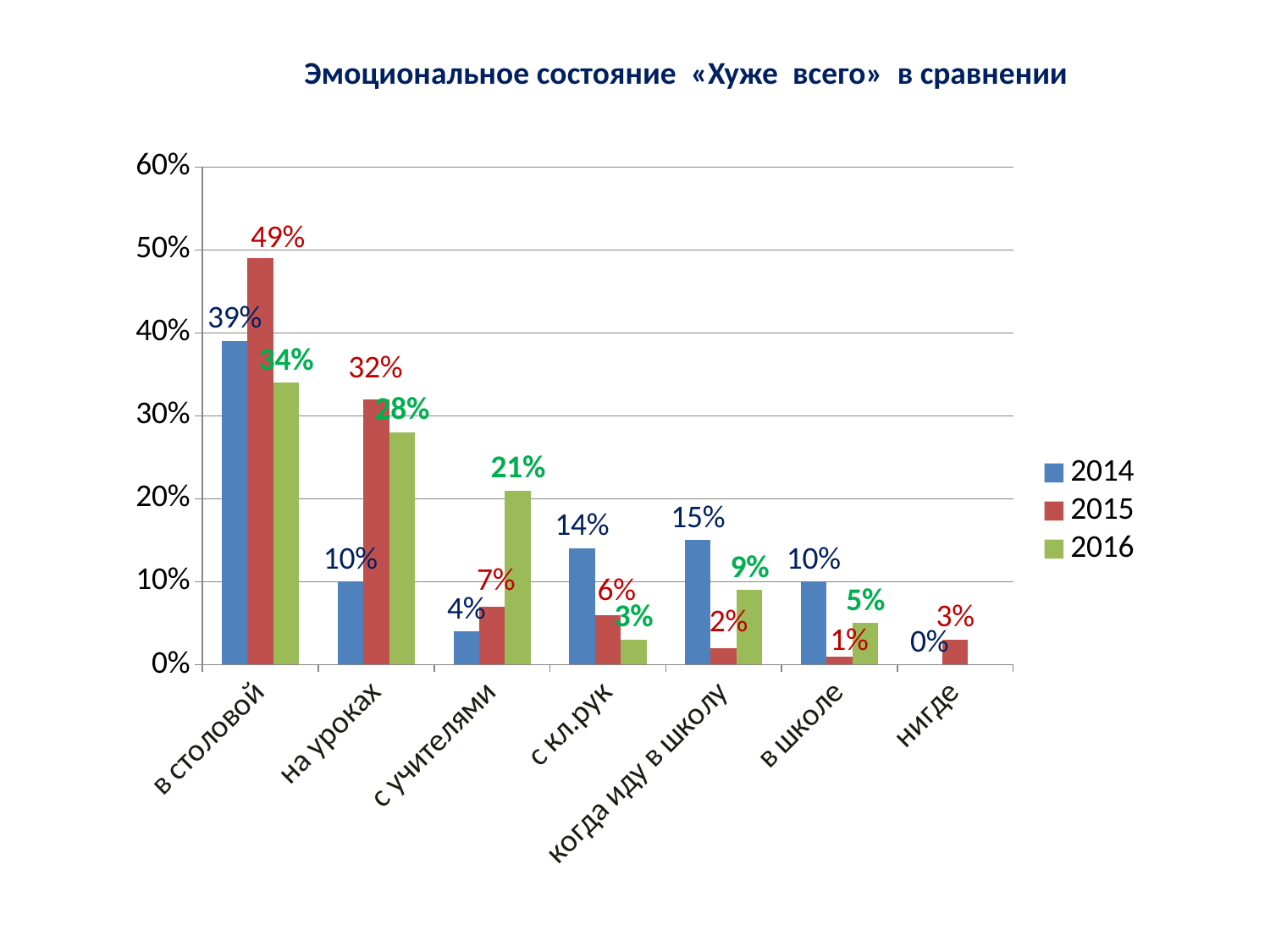
What is the value for 2015 in the category «в столовой»? 49% What is the value for 2015 in the category «в школе»? 1% How many categories are shown on the x axis? 7 Which category has the lowest value for the 2014 series? нигде What kind of chart is shown on the slide? bar chart What is the difference between the 2015 and 2014 values for «на уроках»? 22% What is the value for 2016 in the category «с учителями»? 21% How many series does the legend list? 3 Which category has the highest value for the 2015 series? в столовой Which colour represents the 2016 series in the legend? green Which is larger for «с кл.рук»: the 2014 value or the 2015 value? 2014 What is the value for 2014 in the category «когда иду в школу»? 15%